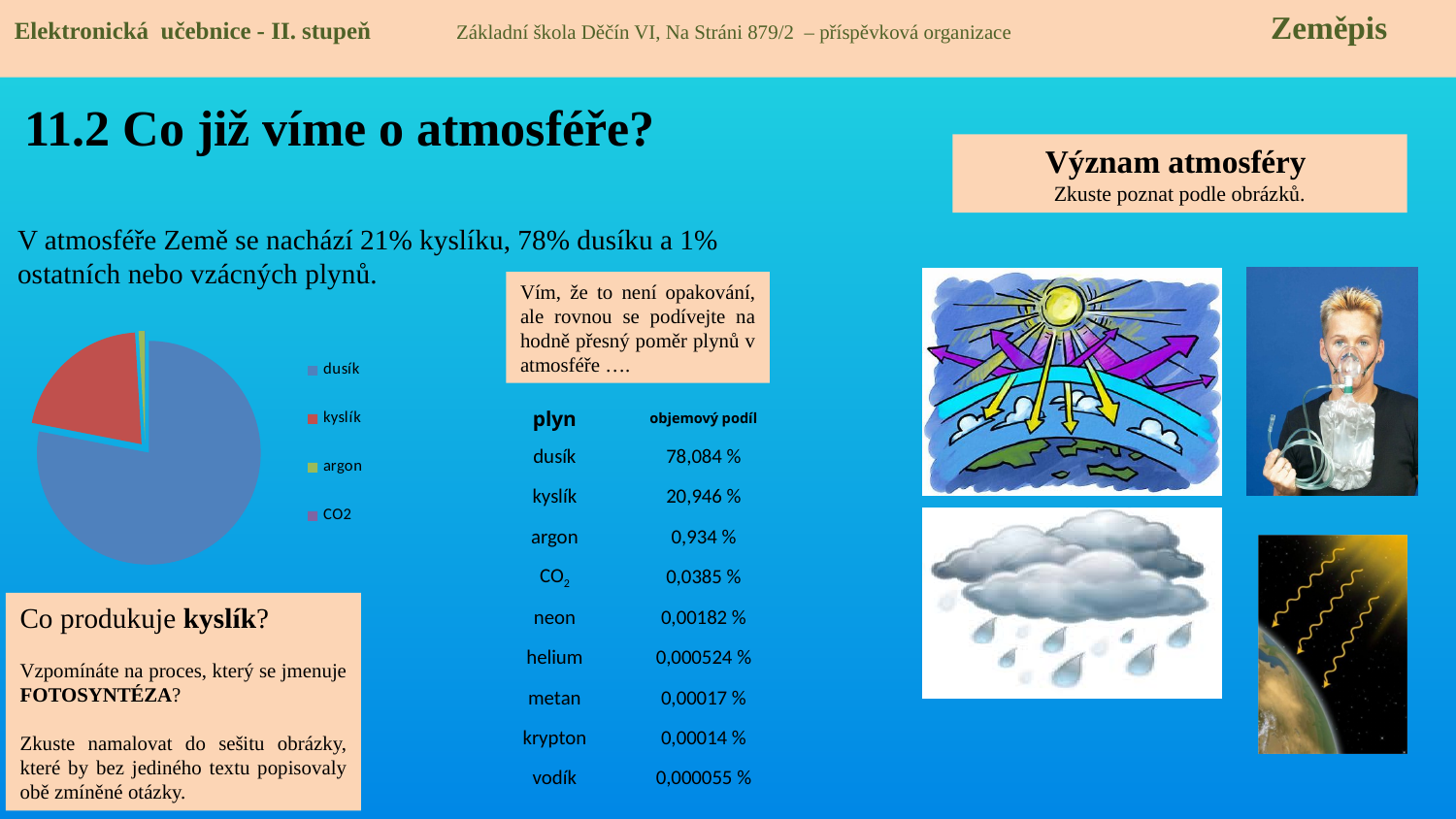
Which category has the largest slice in the pie chart? dusík Which category is listed last in the pie chart's legend? CO2 What kind of chart is shown on the left of the slide? pie chart In the pie chart, which slice is larger, kyslík or argon? kyslík How many categories does the legend of the pie chart list? 4 In the pie chart, which slice is larger, dusík or kyslík? dusík Which colour represents dusík in the pie chart? blue Which colour represents kyslík in the pie chart? red